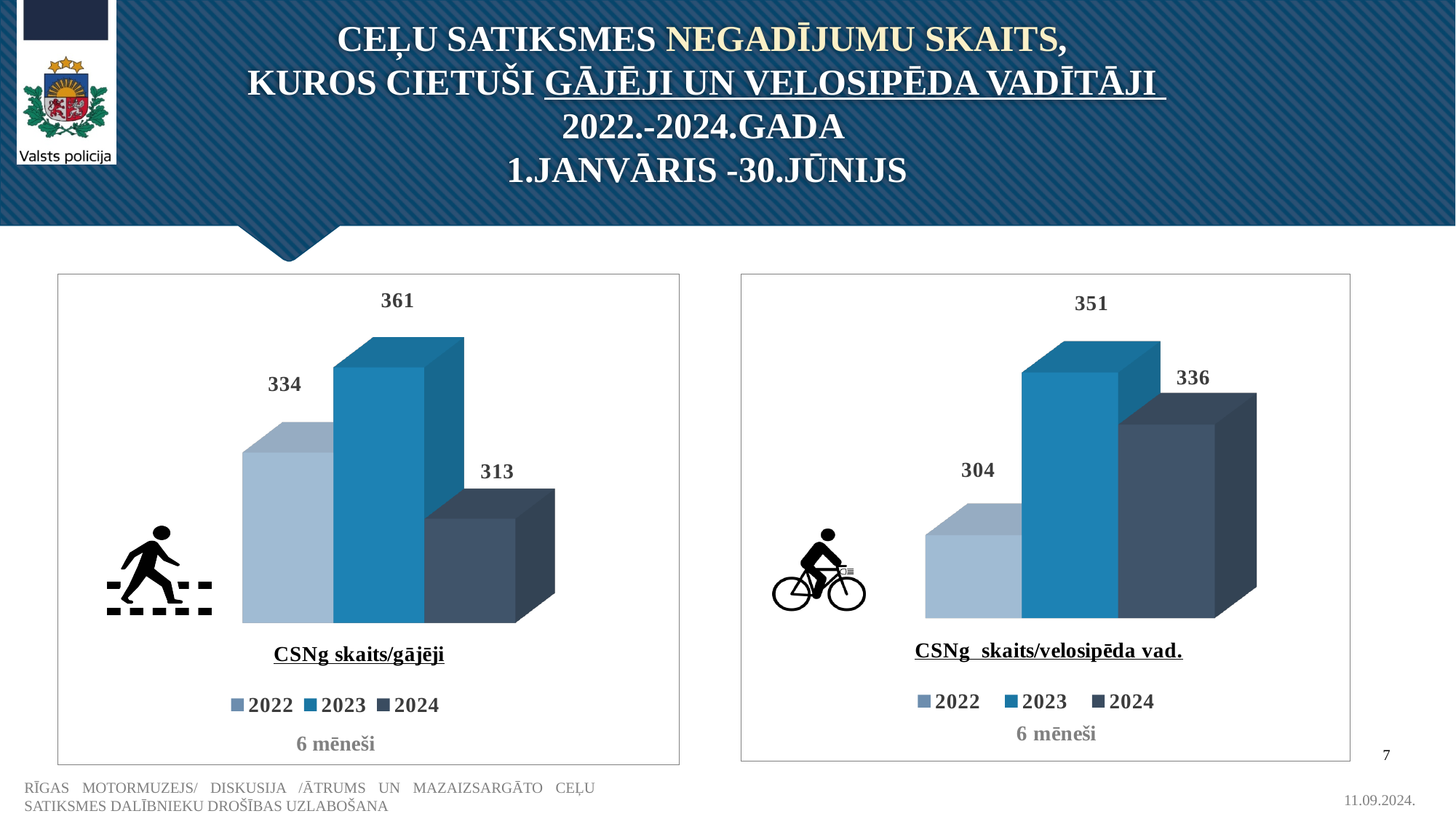
In the right chart (CSNg skaits/velosipēda vad.), what is the value for 2024? 336 In the left chart (CSNg skaits/gājēji), which year has the highest value? 2023 In the right chart (CSNg skaits/velosipēda vad.), which is larger, the value for 2023 or the value for 2024? 2023 In the left chart (CSNg skaits/gājēji), what is the value for 2023? 361 How many series does the legend of the left chart (CSNg skaits/gājēji) list? 3 In the left chart (CSNg skaits/gājēji), what period label is shown below the legend? 6 mēneši In the left chart (CSNg skaits/gājēji), what is the difference between the 2023 and 2024 values? 48 In the right chart (CSNg skaits/velosipēda vad.), which year has the lowest value? 2022 In the left chart (CSNg skaits/gājēji), what is the value for 2024? 313 What kind of chart is the right chart (CSNg skaits/velosipēda vad.)? bar chart In the right chart (CSNg skaits/velosipēda vad.), what is the difference between the 2023 and 2022 values? 47 In the right chart (CSNg skaits/velosipēda vad.), what is the value for 2022? 304